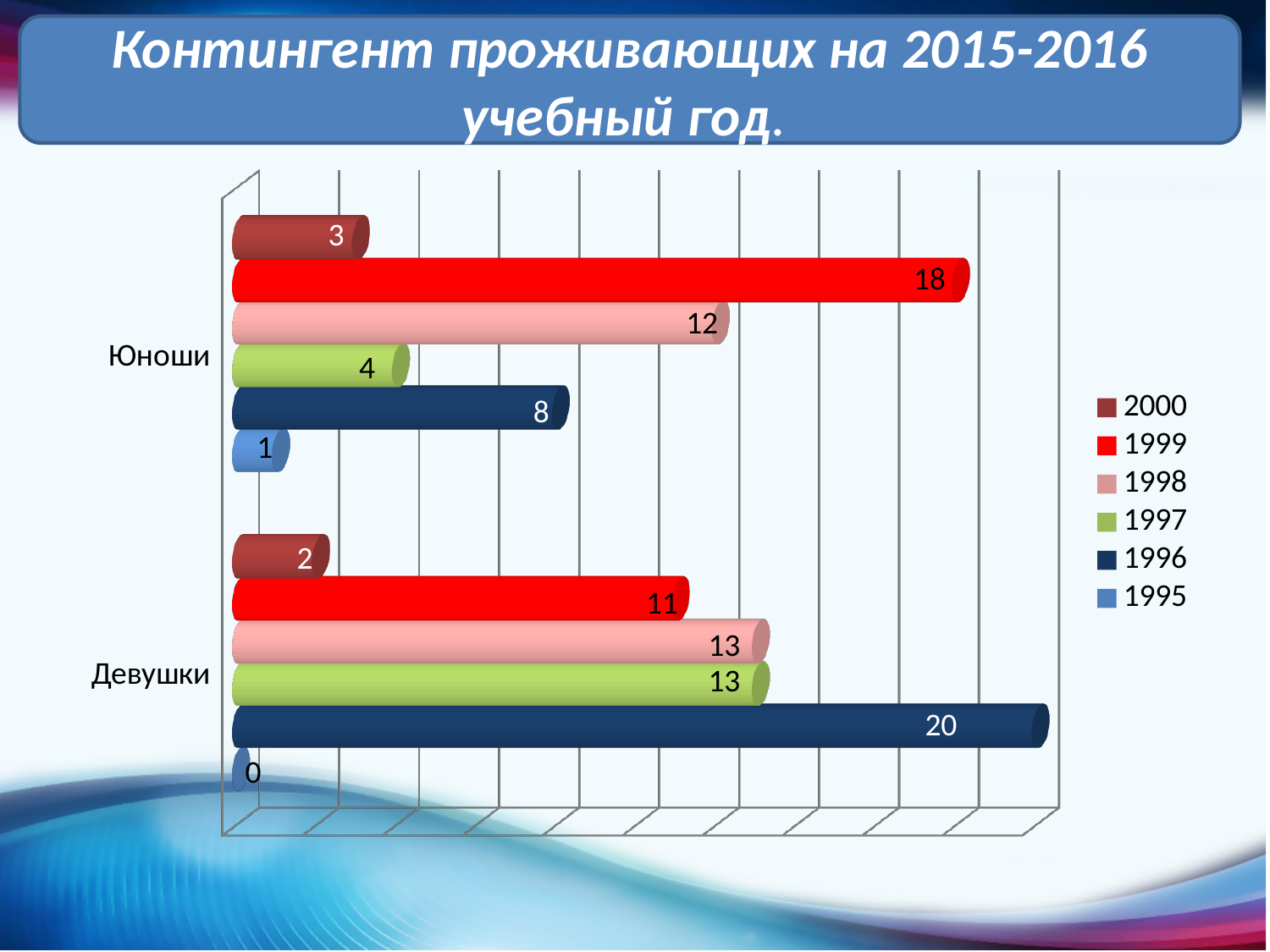
What is the value for Девушки in the 1995 series? 0 What is the value for Девушки in the 1996 series? 20 How many categories are shown on the vertical axis? 2 Which series has the highest value for Юноши? 1999 What is the difference between the 1996 value for Девушки and the 1996 value for Юноши? 12 Which is larger: the 1999 value for Юноши or the 1999 value for Девушки? Юноши What is the value for Юноши in the 1995 series? 1 Which series has the lowest value for Девушки? 1995 What is the title of the chart on the slide? Контингент проживающих на 2015-2016 учебный год. What kind of chart is shown on the slide? Bar chart How many series does the legend list? 6 What is the value for Юноши in the 1999 series? 18